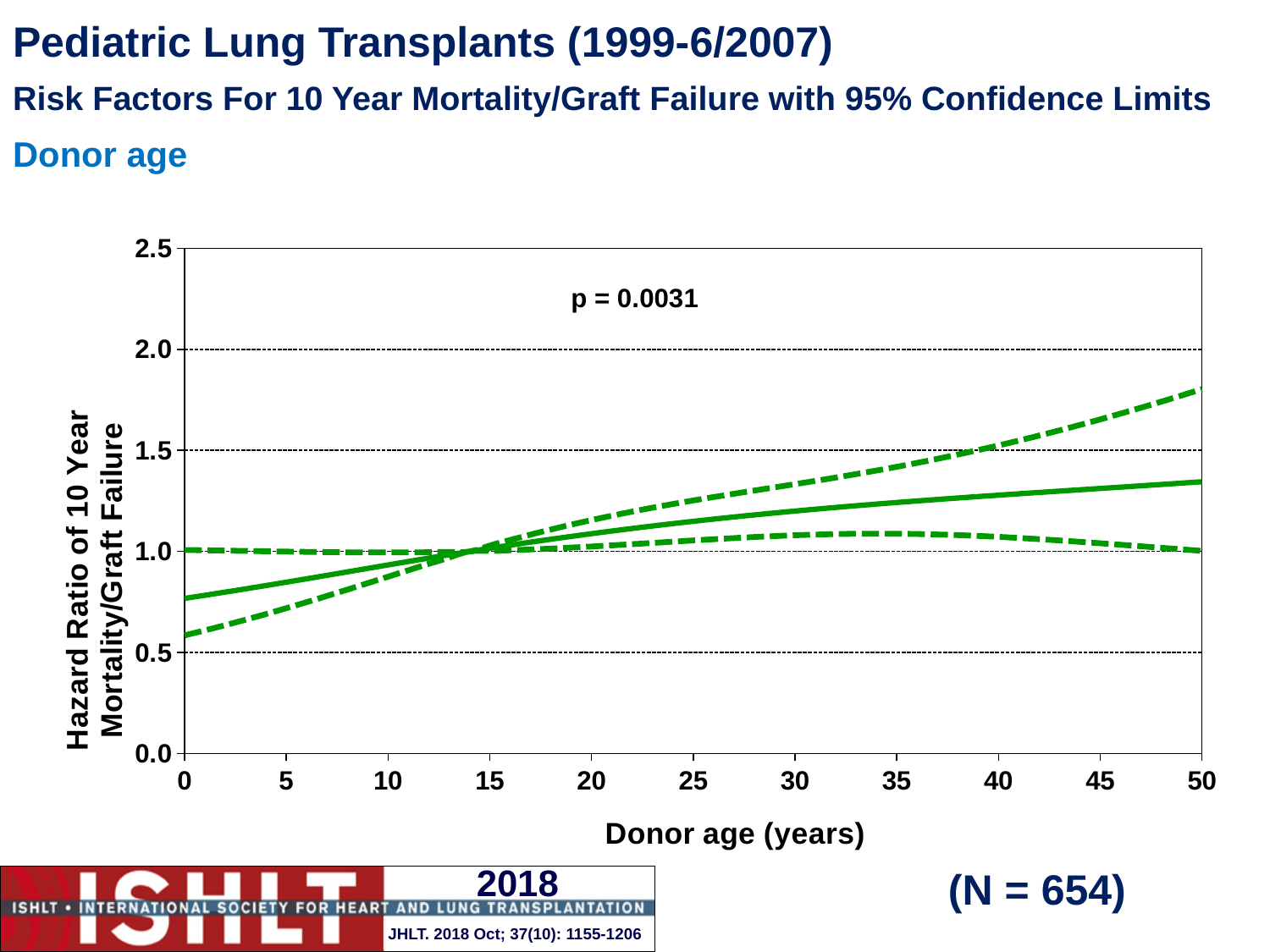
What kind of chart is shown on the slide? line chart Is the solid hazard ratio line at donor age 0 greater or less than 1.0? less Which is larger, the solid hazard ratio line at donor age 50 or at donor age 0? donor age 50 Is the solid hazard ratio line at donor age 50 greater or less than 1.5? less What p-value is printed on the chart? p = 0.0031 Is the upper dashed confidence limit at donor age 50 greater or less than 1.5? greater How many lines are plotted on the chart? 3 Does the solid hazard ratio line rise or fall as donor age increases from 0 to 50 years? rise What is the highest value shown on the y axis? 2.5